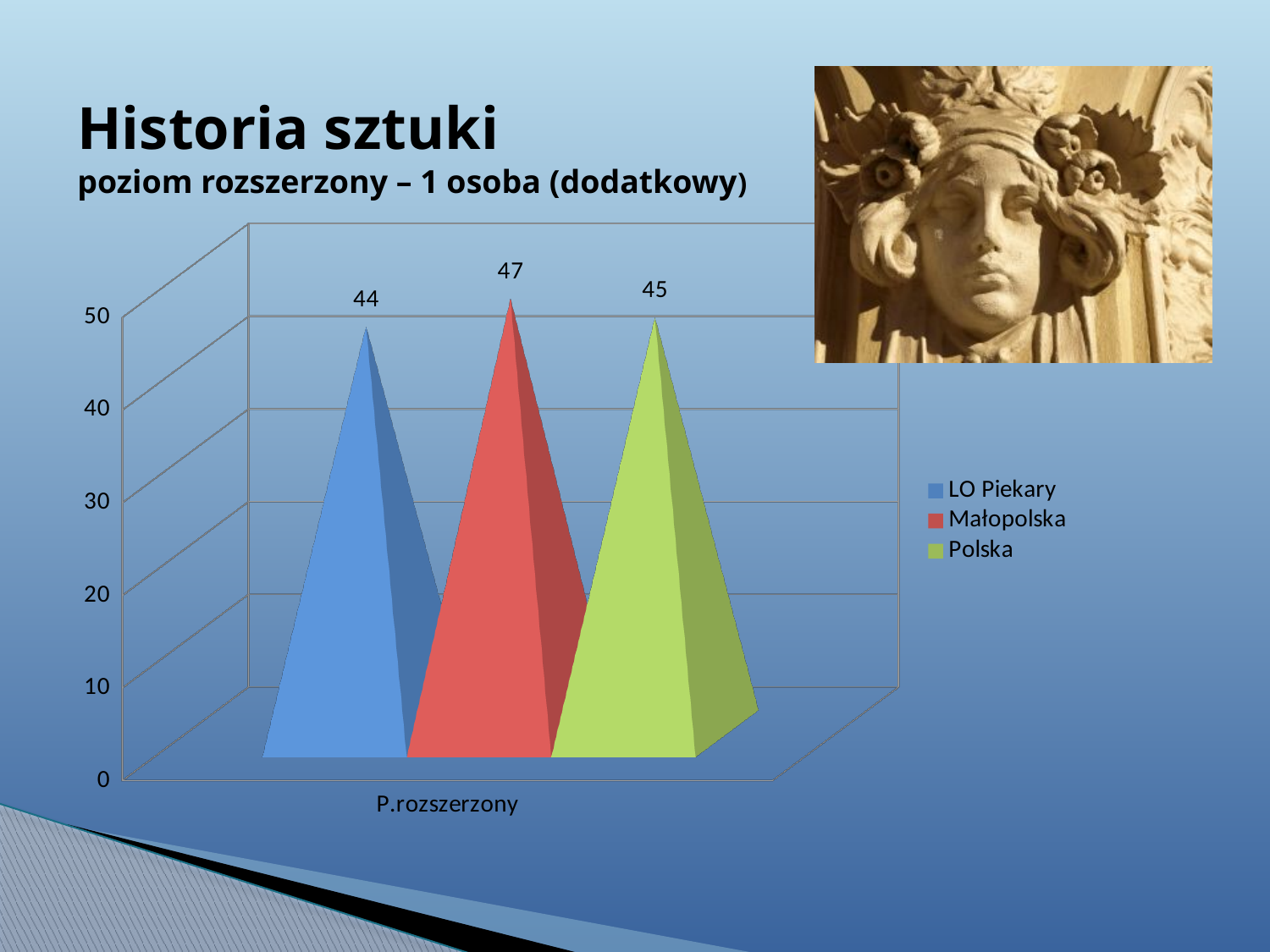
Which series has the highest value? Małopolska Which series has the lowest value? LO Piekary Is the value for LO Piekary greater or less than 40? greater Which is larger, the value for Małopolska or the value for Polska? Małopolska What is the label on the x axis category? P.rozszerzony How many series does the legend list? 3 What is the value for LO Piekary? 44 What is the difference between the values for Polska and LO Piekary? 1 What kind of chart is shown on the slide? bar chart What is the value for Polska? 45 What is the value for Małopolska? 47 What is the difference between the values for Małopolska and LO Piekary? 3